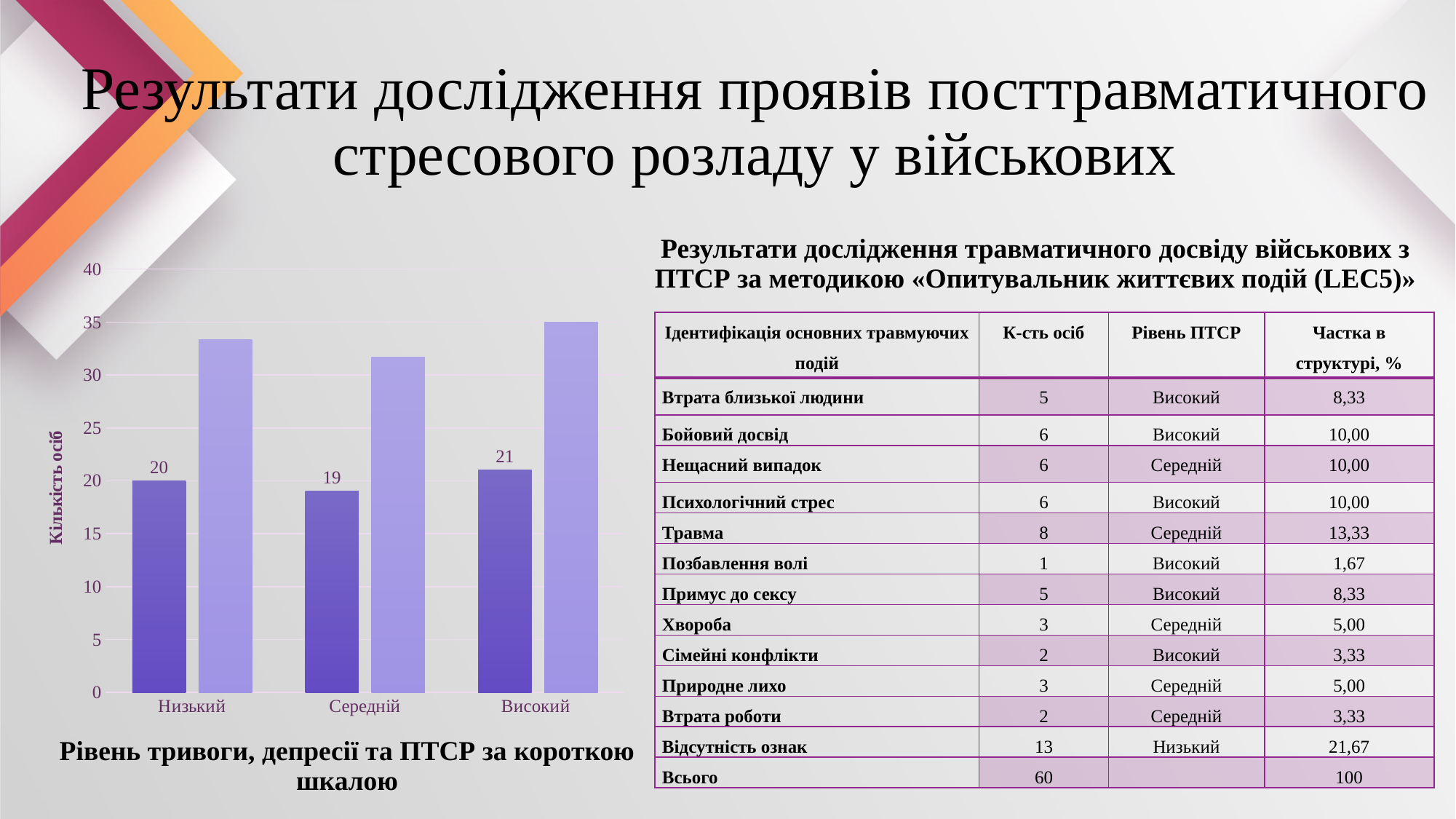
Is the light purple bar for Середній greater or less than 30? greater What kind of chart is shown on the slide? bar chart Among the dark purple bars, which category has the lowest value? Середній What is the value of the dark purple bar for Середній? 19 How many categories are shown on the x axis of the chart? 3 What is the value of the dark purple bar for Високий? 21 Among the dark purple bars, which category has the highest value? Високий What is the title of the vertical axis of the chart? Кількість осіб What is the value of the dark purple bar for Низький? 20 For the category Низький, which bar is larger: the dark purple bar or the light purple bar? the light purple bar Is the light purple bar for Низький greater or less than 30? greater What is the difference between the dark purple bar values for Високий and Середній? 2